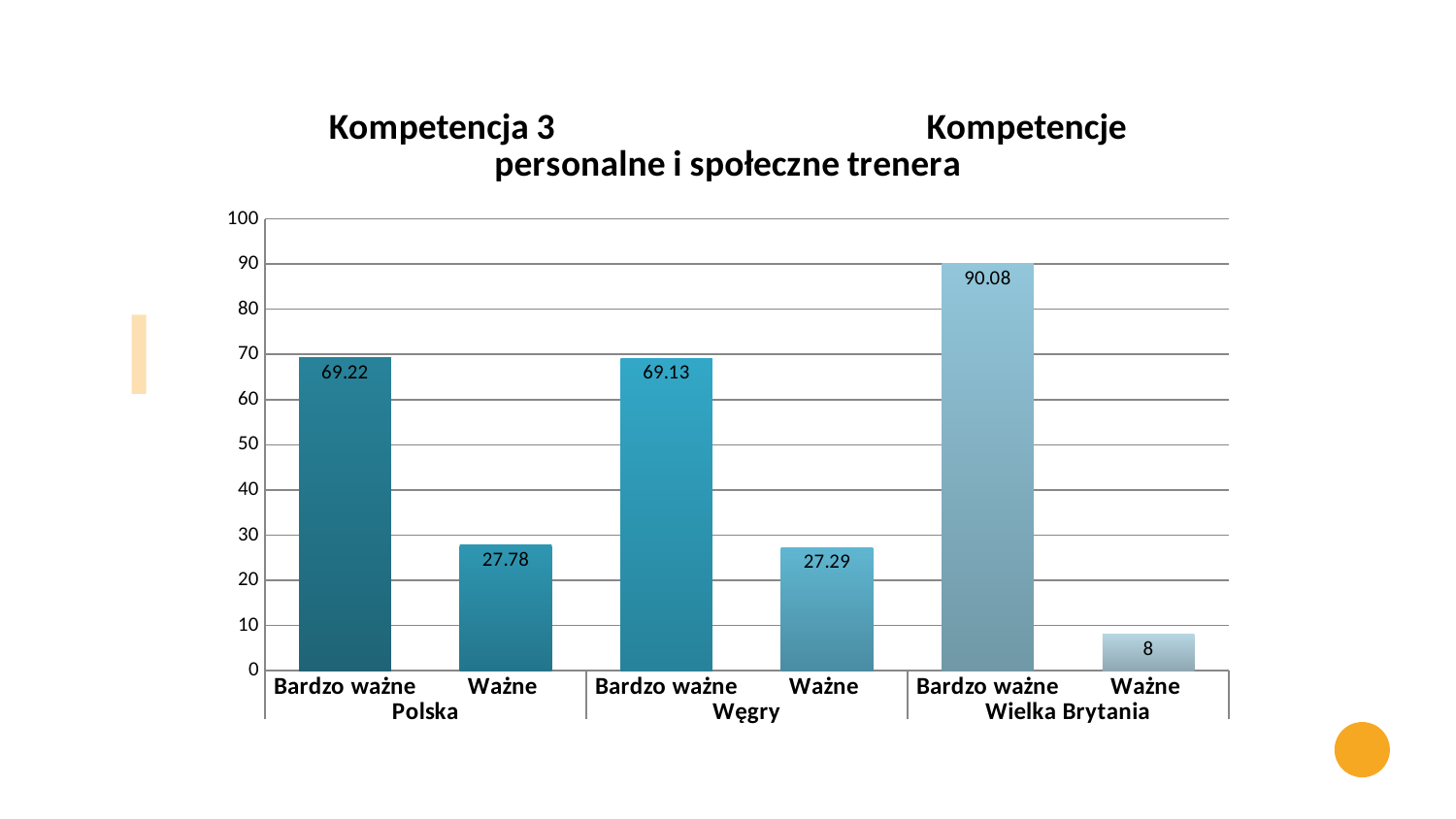
What is the difference between "Bardzo ważne" and "Ważne" in Polska? 41.44 What is the value for "Bardzo ważne" in Wielka Brytania? 90.08 How many bars are plotted in the chart? 6 What is the value for "Ważne" in Wielka Brytania? 8 What is the difference between "Bardzo ważne" in Wielka Brytania and "Bardzo ważne" in Węgry? 20.95 What is the value for "Bardzo ważne" in Polska? 69.22 Which bar has the lowest value? Ważne, Wielka Brytania How many countries are shown on the x axis? 3 What is the value for "Ważne" in Węgry? 27.29 What kind of chart is shown on the slide? Bar chart Which is larger: "Ważne" in Polska or "Ważne" in Węgry? Ważne in Polska Which bar has the highest value? Bardzo ważne, Wielka Brytania